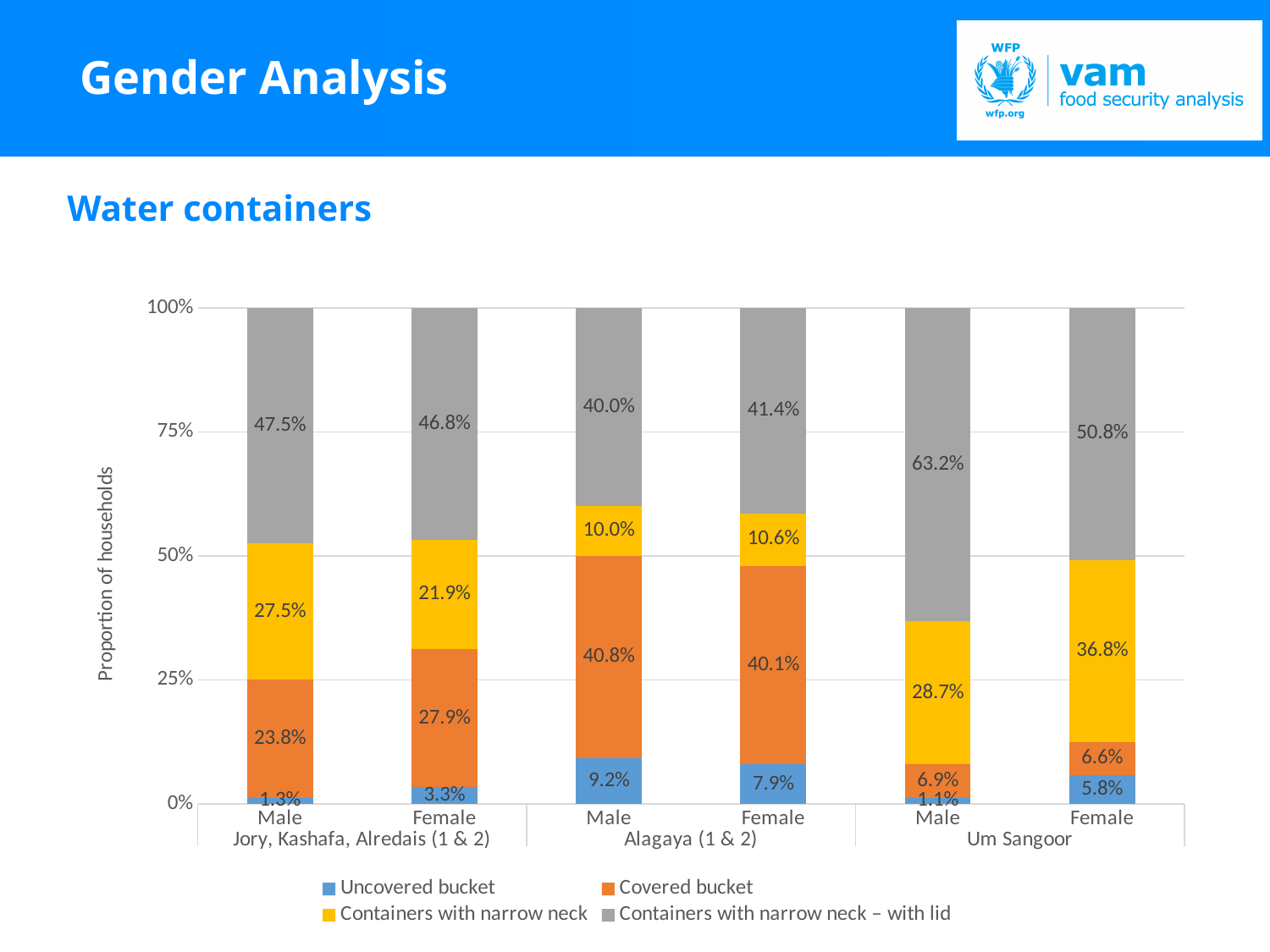
Which group has the lowest value for Uncovered bucket? Male, Um Sangoor What is the label of the vertical axis? Proportion of households How many series does the legend list? 4 What percentage of male-headed households in Um Sangoor use containers with narrow neck – with lid? 63.2% Which group has the highest value for Containers with narrow neck – with lid? Male, Um Sangoor What share of female-headed households in Jory, Kashafa, Alredais (1 & 2) use an uncovered bucket? 3.3% What is the value for Covered bucket among female-headed households in Alagaya (1 & 2)? 40.1% How many bars are shown in the chart? 6 What is the value for Containers with narrow neck for female-headed households in Um Sangoor? 36.8% What type of chart is shown on the slide? Stacked bar chart What is the difference between the Covered bucket values for male and female households in Jory, Kashafa, Alredais (1 & 2)? 4.1% Which is larger: the Containers with narrow neck value for males in Um Sangoor or for females in Um Sangoor? Female